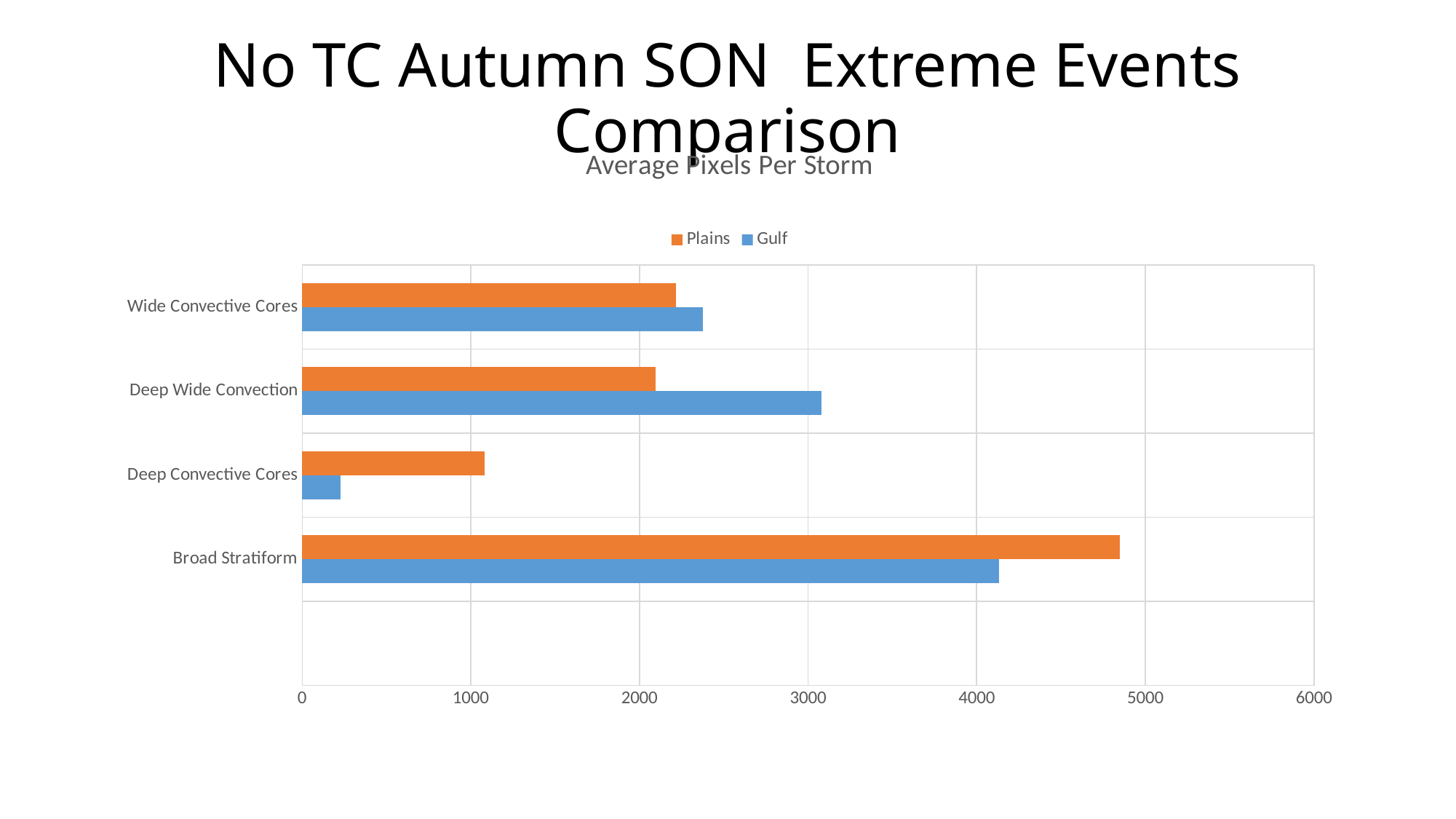
Which category has the lowest Plains value? Deep Convective Cores What is the title of the chart? Average Pixels Per Storm Which category has the lowest Gulf value? Deep Convective Cores Is the Plains value for Broad Stratiform greater or less than 5000? less Is the Gulf value for Deep Wide Convection greater or less than 3000? greater How many series does the legend list? 2 Which category has the highest Plains value? Broad Stratiform What kind of chart is shown on the slide? bar chart Is the Gulf value for Deep Convective Cores greater or less than 1000? less For Deep Wide Convection, which is larger, the Plains value or the Gulf value? Gulf For Broad Stratiform, which is larger, the Plains value or the Gulf value? Plains How many categories are shown on the chart? 4